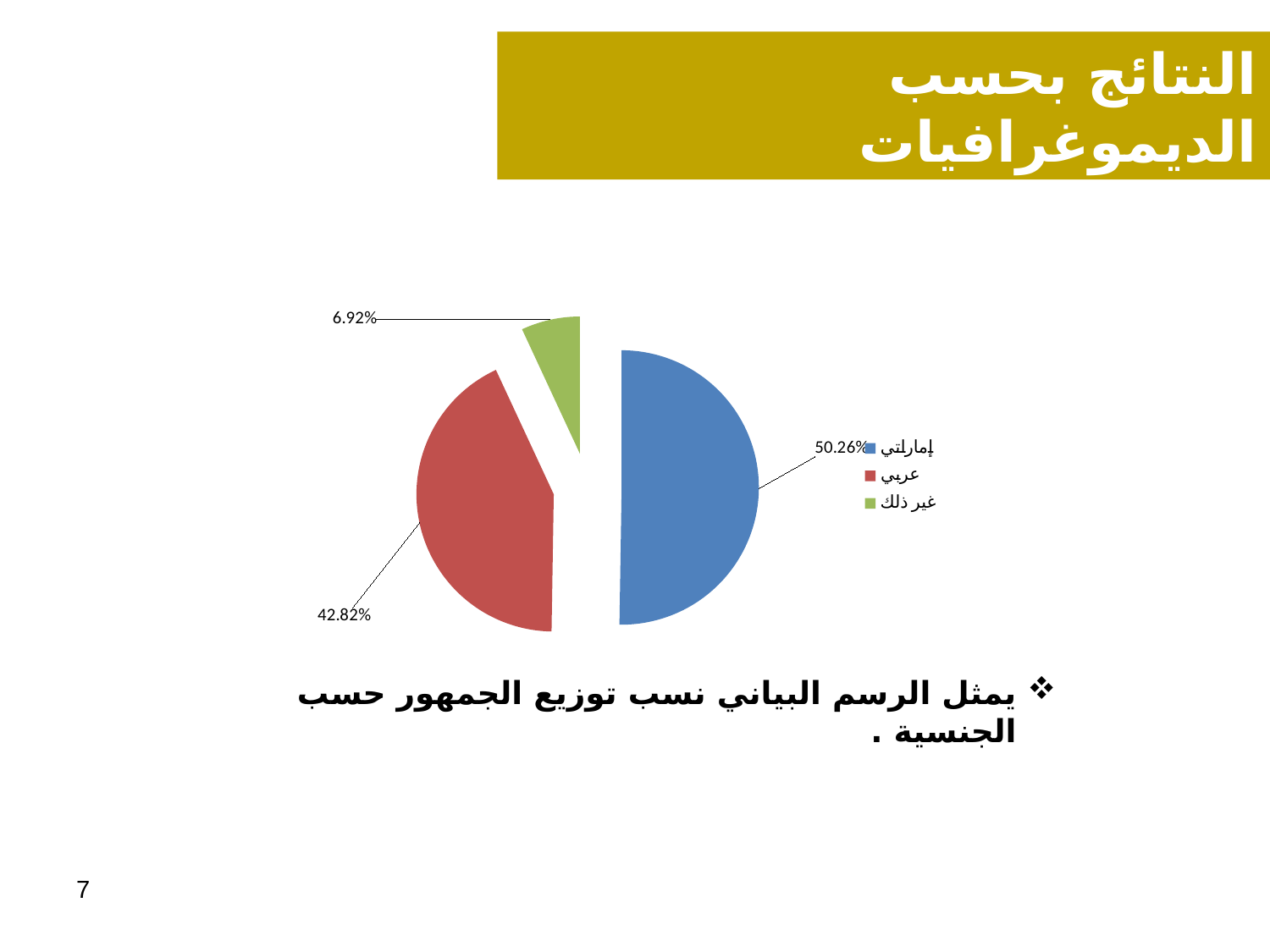
How many slices does the pie chart have? 3 What percentage is shown for the عربي slice? 42.82% What is the difference in percentage points between the عربي and غير ذلك slices? 35.90 Which category has the smallest share of the pie? غير ذلك What colour is the عربي slice in the pie chart? red What percentage is shown for the غير ذلك slice? 6.92% Which category has the largest share of the pie? إماراتي How many entries does the legend list? 3 What type of chart is shown on the slide? pie chart What percentage of the pie does the إماراتي slice represent? 50.26% Which is larger, the عربي slice or the غير ذلك slice? عربي What is the difference in percentage points between the إماراتي and عربي slices? 7.44